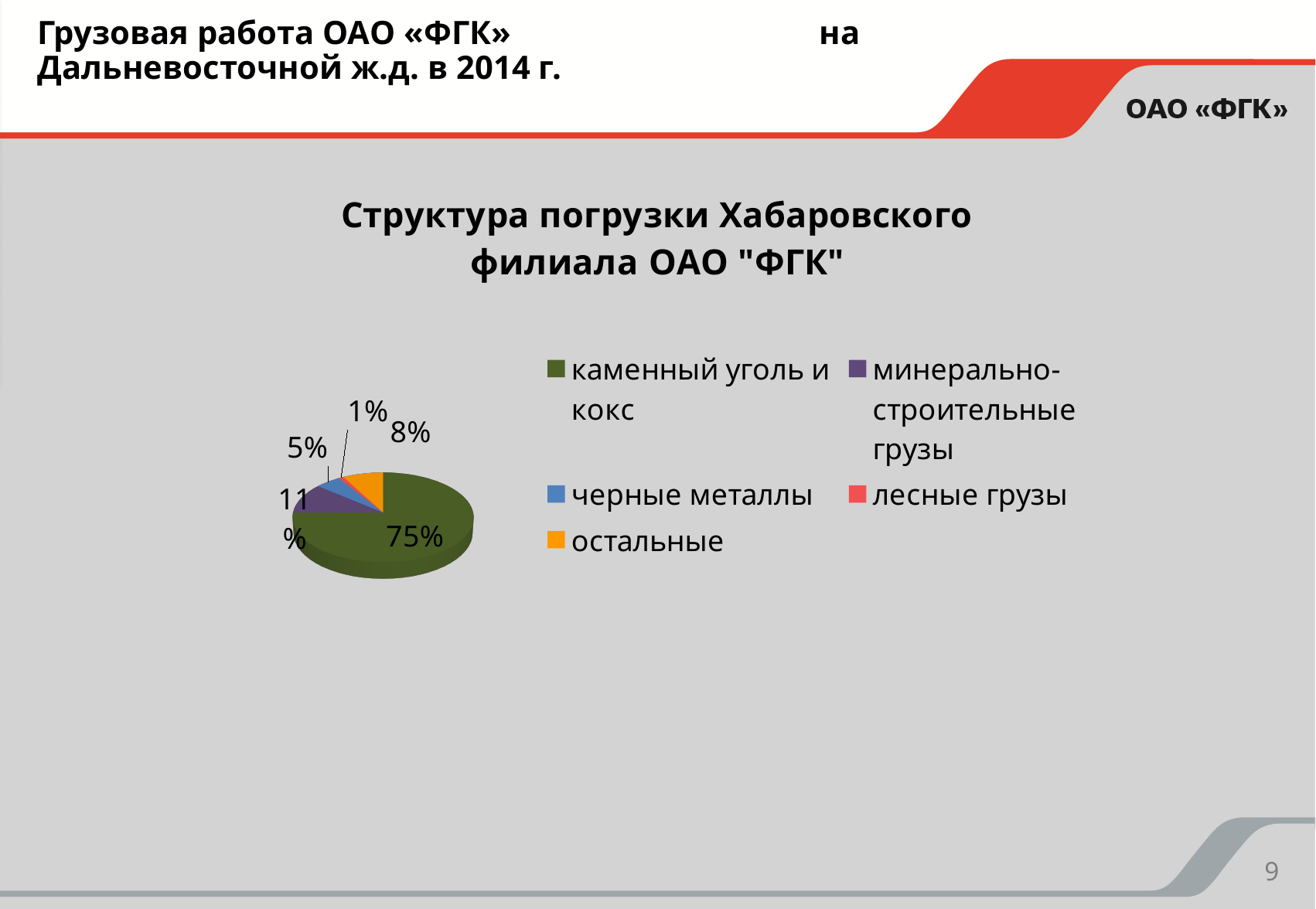
What share of the pie does "остальные" have? 8% How many categories does the pie chart have? 5 What kind of chart is shown on the slide? pie chart Which is larger: the share of "остальные" or the share of "черные металлы"? остальные What share of the pie does "минерально-строительные грузы" have? 11% What share of the pie does "черные металлы" have? 5% Which category has the smallest slice of the pie? лесные грузы What is the title of the chart? Структура погрузки Хабаровского филиала ОАО "ФГК" What is the difference between the shares of "каменный уголь и кокс" and "минерально-строительные грузы"? 64% Which category has the largest slice of the pie? каменный уголь и кокс